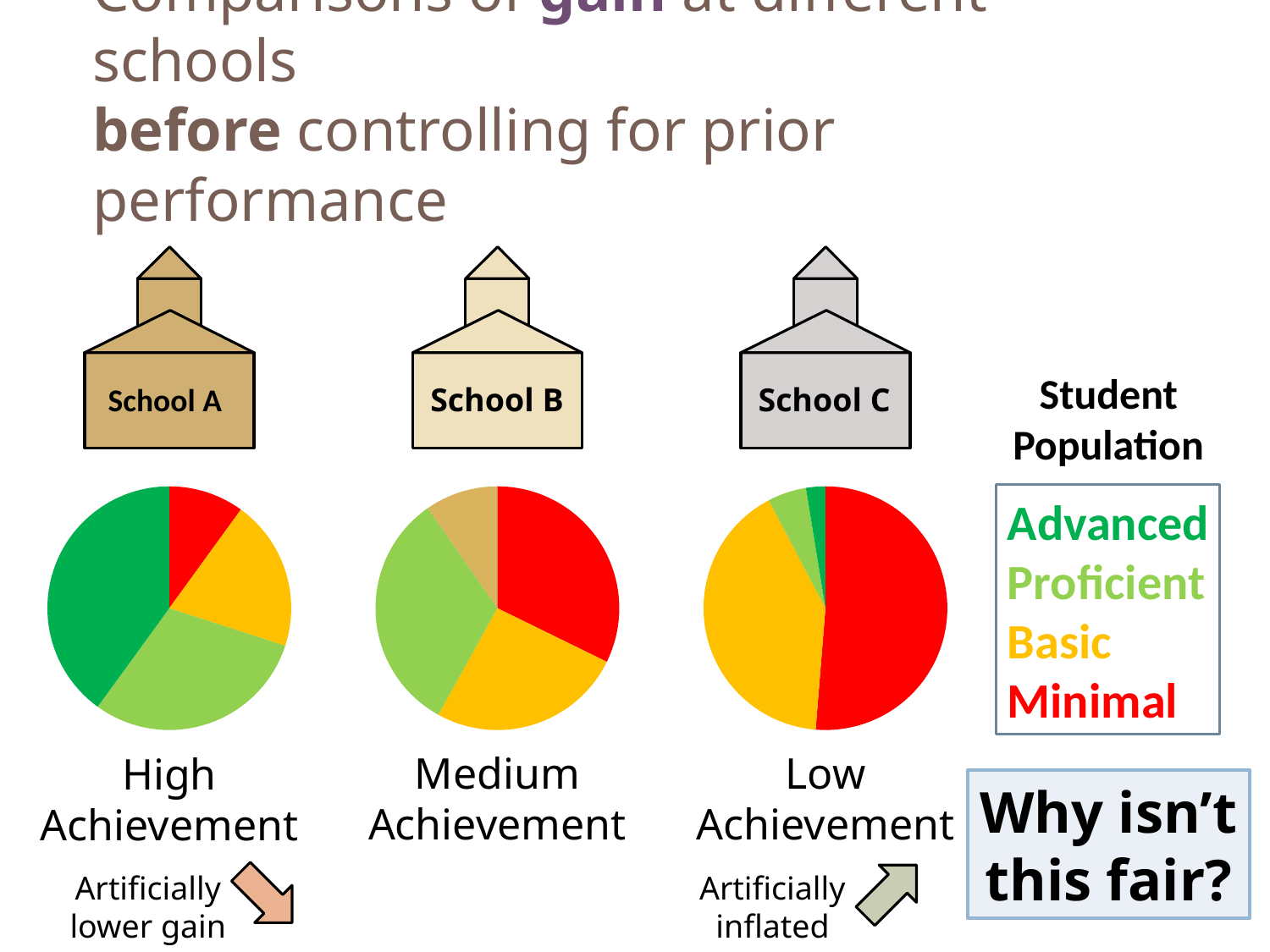
What kind of chart is used for School A? pie chart How many categories does the Student Population legend list? 4 Which colour represents the Minimal category in the legend? red In the School A pie chart, which category has the smallest slice? Minimal In the School C pie chart, which slice is larger, Minimal or Basic? Minimal In the School C pie chart, which category has the largest slice? Minimal In the School C pie chart, which slice is larger, Proficient or Advanced? Proficient Which school's pie chart is labelled Low Achievement? School C How many charts are shown on the slide? 3 In the School C pie chart, which category has the smallest slice? Advanced How many slices does the School A pie chart have? 4 In the School A pie chart, which slice is larger, Basic or Minimal? Basic